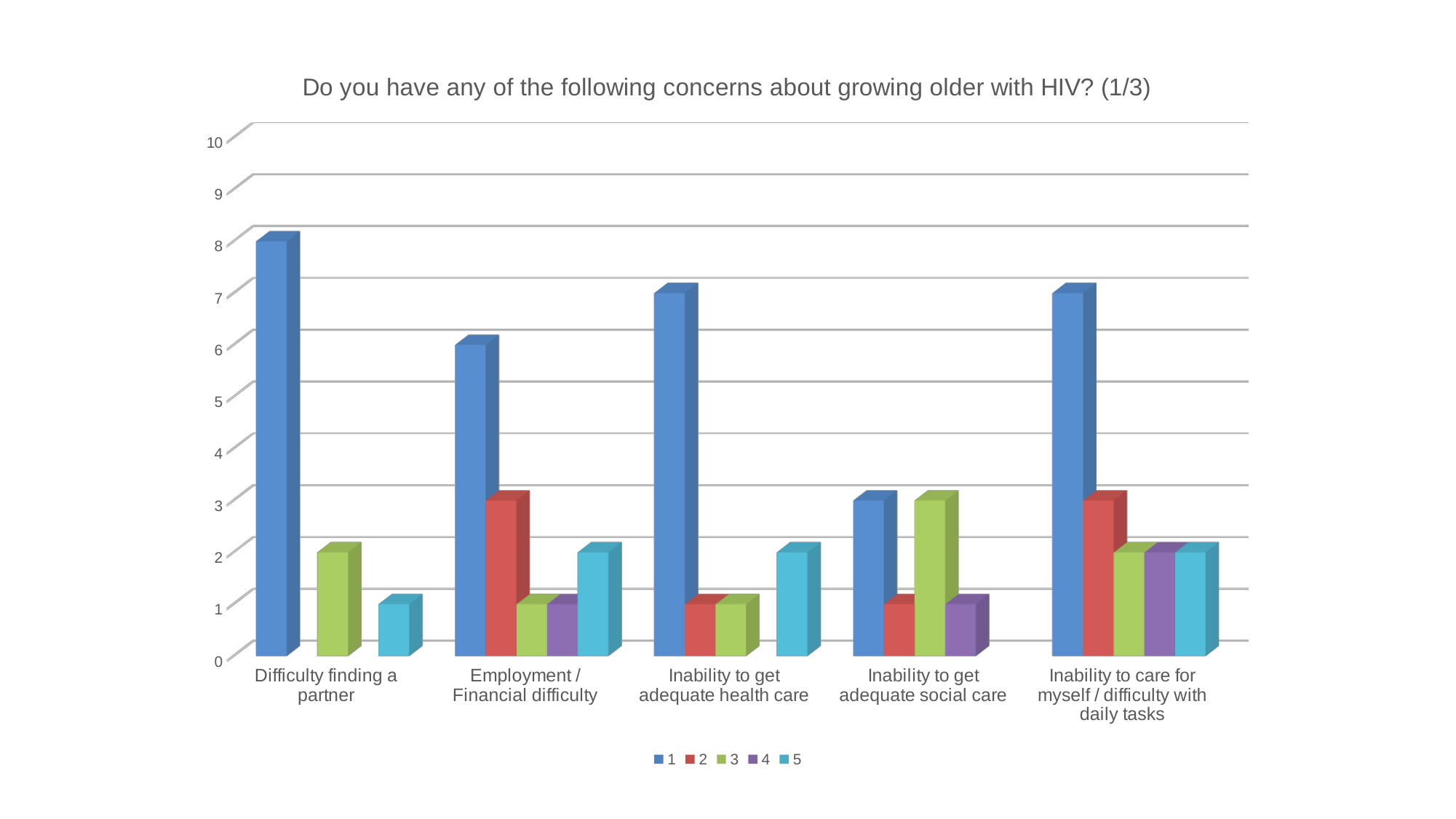
How many series does the legend list? 5 Is the value for series 1 in 'Difficulty finding a partner' greater or less than 7? greater Which category has the lowest value for series 1? Inability to get adequate social care Is the value for series 1 in 'Employment / Financial difficulty' greater or less than 5? greater Is the value for series 2 in 'Inability to get adequate health care' greater or less than 2? less Which is larger for 'Employment / Financial difficulty': series 2 or series 5? series 2 What is the title of the chart? Do you have any of the following concerns about growing older with HIV? (1/3) Which category has no bar for series 2? Difficulty finding a partner How many concern categories are shown on the x axis? 5 What kind of chart is shown on the slide? bar chart Which is larger for 'Inability to get adequate social care': series 1 or series 2? series 1 Which category has the highest value for series 1? Difficulty finding a partner